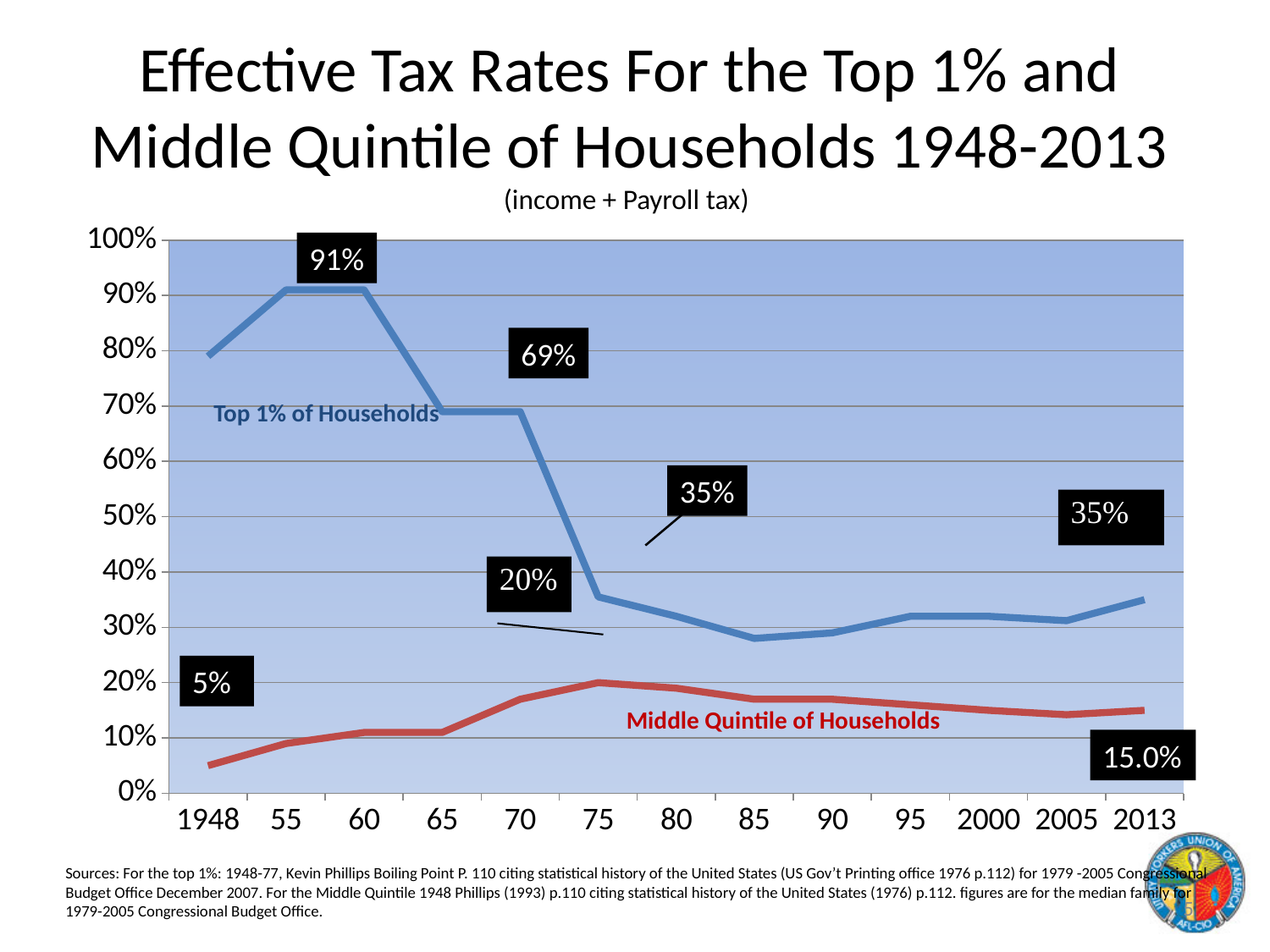
Does the Top 1% of Households line rise or fall between 1960 and 1985? fall What is the highest labeled effective tax rate for the Top 1% of Households? 91% How many data series are plotted on the chart? 2 What is the effective tax rate for the Top 1% of Households in 2013? 35% Is the value for the Top 1% of Households in 1948 greater or less than 70%? greater What is the difference between the 91% peak and the 69% value for the Top 1% of Households? 22% What is the difference between the Top 1% rate and the Middle Quintile rate in 2013? 20% What is the effective tax rate for the Middle Quintile of Households in 2013? 15.0% How many years are marked on the x axis? 13 What is the effective tax rate for the Middle Quintile of Households in 1948? 5% What type of chart is shown on the slide? line chart Which series has the higher effective tax rate in 1948, Top 1% of Households or Middle Quintile of Households? Top 1% of Households